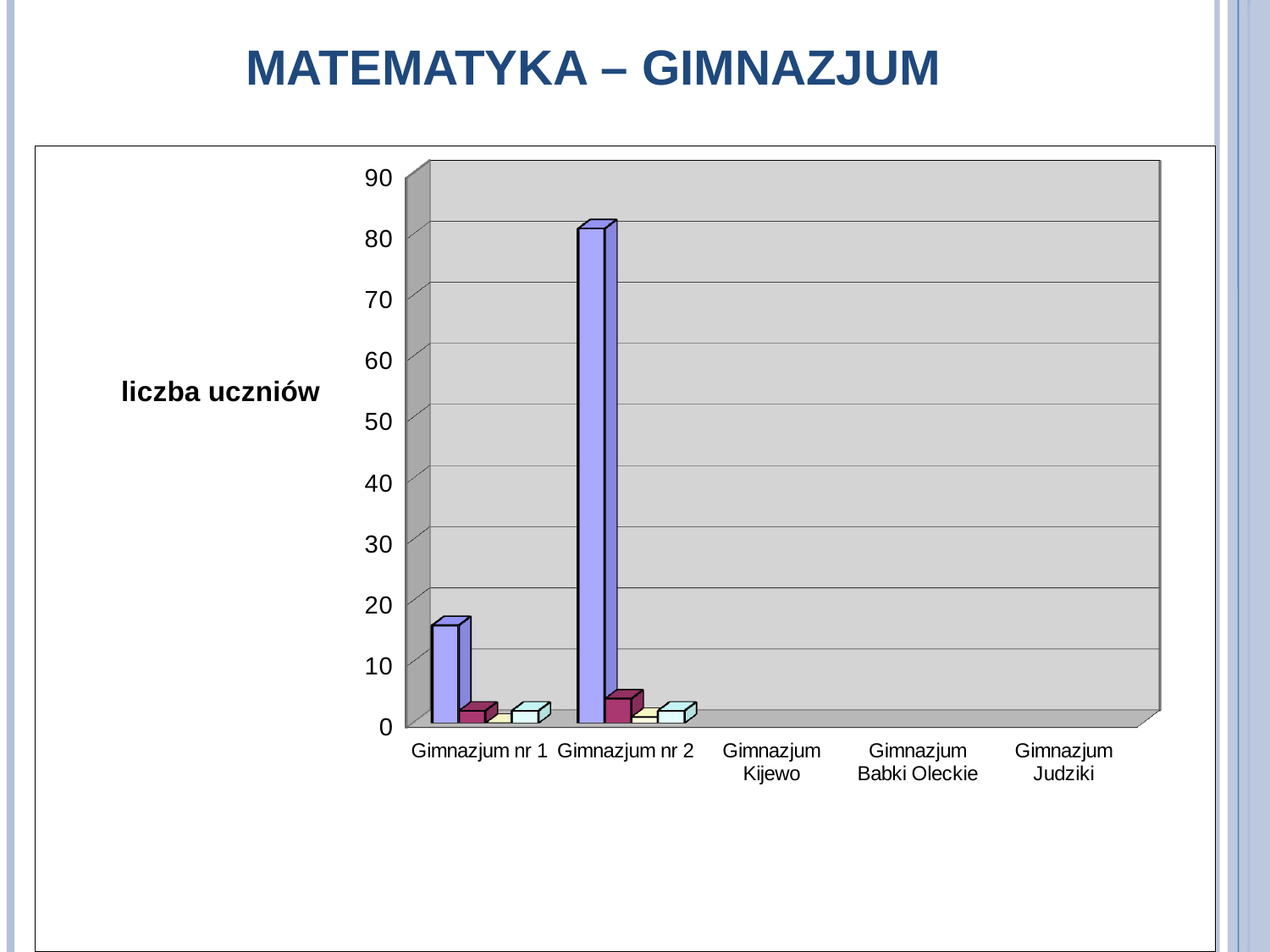
Is the tallest bar for Gimnazjum nr 1 greater or less than 10? greater Which category has the tallest bar in the chart? Gimnazjum nr 2 How many categories are shown on the x axis of the chart? 5 What is the label of the vertical axis of the chart? liczba uczniów What is the highest value shown on the vertical axis of the chart? 90 Is the tallest bar for Gimnazjum nr 2 greater or less than 70? greater Is the tallest bar for Gimnazjum nr 1 greater or less than 20? less Which categories on the chart show no visible bars? Gimnazjum Kijewo, Gimnazjum Babki Oleckie, Gimnazjum Judziki Which has the taller first (blue) bar: Gimnazjum nr 1 or Gimnazjum nr 2? Gimnazjum nr 2 What kind of chart is shown on the slide? bar chart